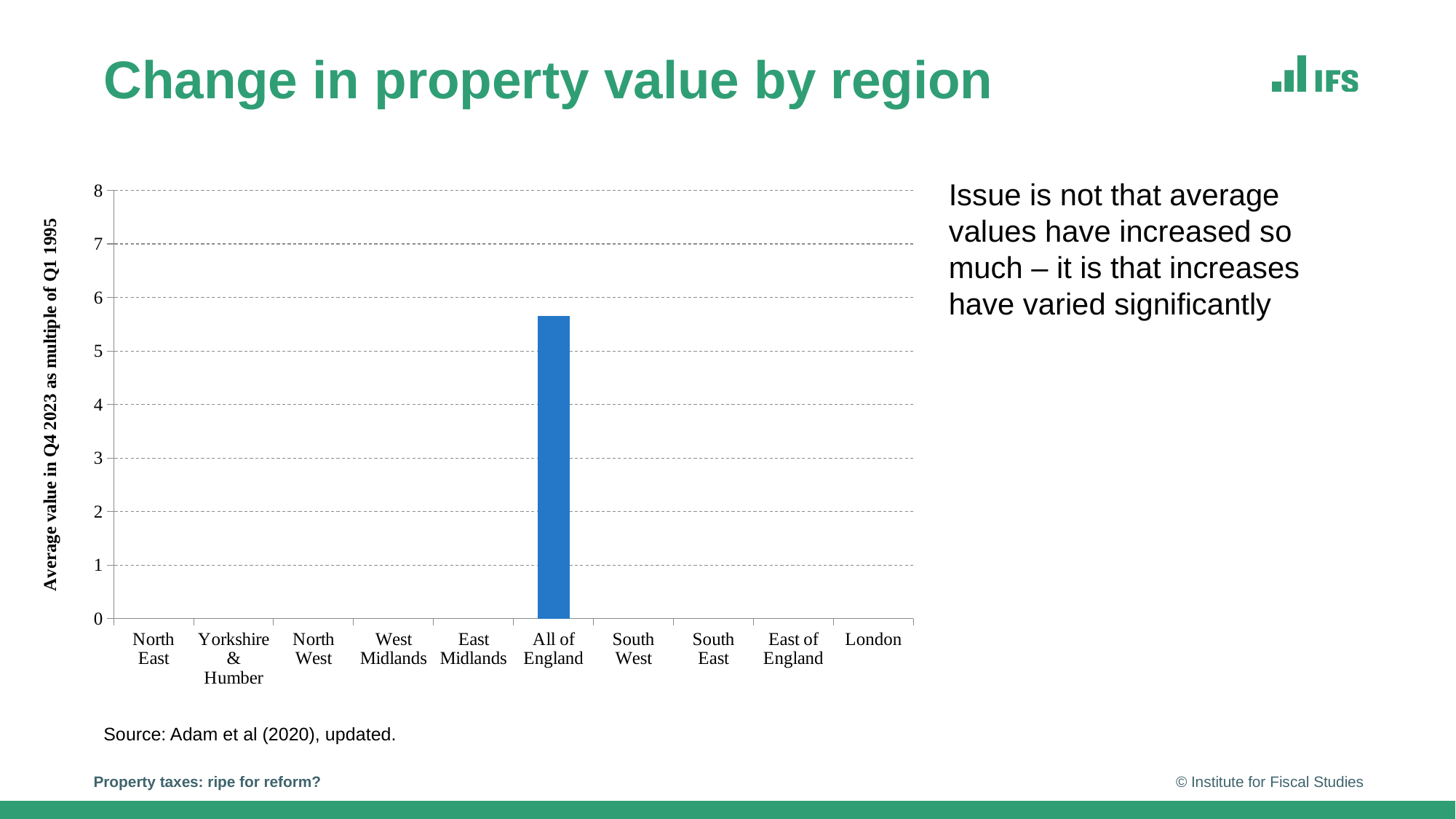
What kind of chart is shown on the slide? Bar chart What is the highest value shown on the y axis of the chart? 8 Is the value for All of England greater or less than 5? greater How many regions are labelled along the x axis of the chart? 10 Which region is labelled furthest to the right on the x axis? London Is the value for All of England greater or less than 6? less Which category is the only one with a bar plotted on the chart? All of England Which category has the tallest bar on the chart? All of England